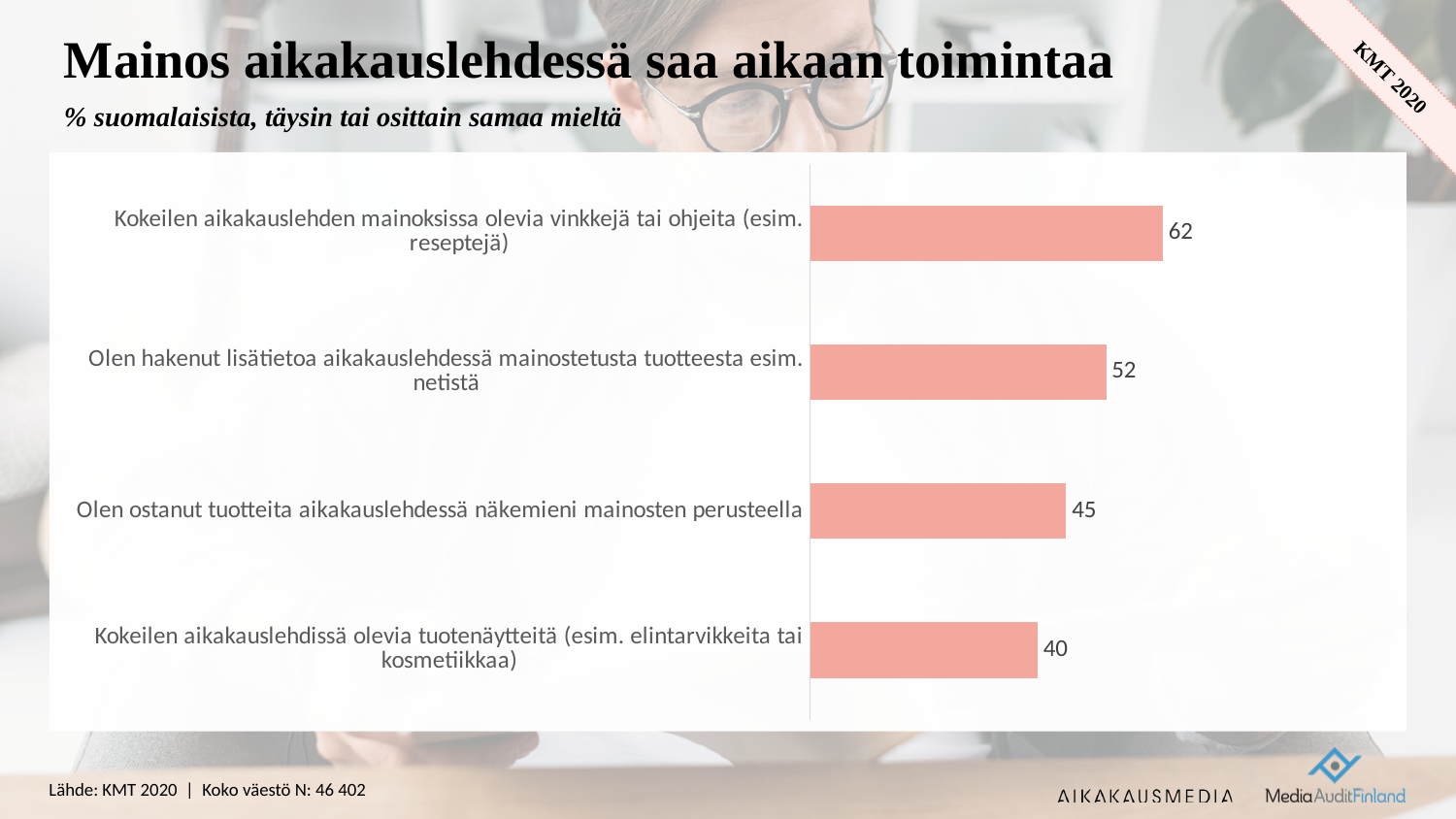
What is the value for "Olen hakenut lisätietoa aikakauslehdessä mainostetusta tuotteesta esim. netistä"? 52 Which category has the highest value? Kokeilen aikakauslehden mainoksissa olevia vinkkejä tai ohjeita (esim. reseptejä) What kind of chart is shown on the slide? Bar chart How many categories are shown in the chart? 4 What is the difference between the values for "Olen hakenut lisätietoa aikakauslehdessä mainostetusta tuotteesta esim. netistä" and "Olen ostanut tuotteita aikakauslehdessä näkemieni mainosten perusteella"? 7 What is the title of the slide? Mainos aikakauslehdessä saa aikaan toimintaa What is the value for "Kokeilen aikakauslehdissä olevia tuotenäytteitä (esim. elintarvikkeita tai kosmetiikkaa)"? 40 Which category has the lowest value? Kokeilen aikakauslehdissä olevia tuotenäytteitä (esim. elintarvikkeita tai kosmetiikkaa) What is the difference between the highest and lowest values in the chart? 22 Which is larger: the value for "Olen ostanut tuotteita aikakauslehdessä näkemieni mainosten perusteella" or for "Kokeilen aikakauslehdissä olevia tuotenäytteitä (esim. elintarvikkeita tai kosmetiikkaa)"? Olen ostanut tuotteita aikakauslehdessä näkemieni mainosten perusteella What is the value for "Olen ostanut tuotteita aikakauslehdessä näkemieni mainosten perusteella"? 45 What is the value for "Kokeilen aikakauslehden mainoksissa olevia vinkkejä tai ohjeita (esim. reseptejä)"? 62